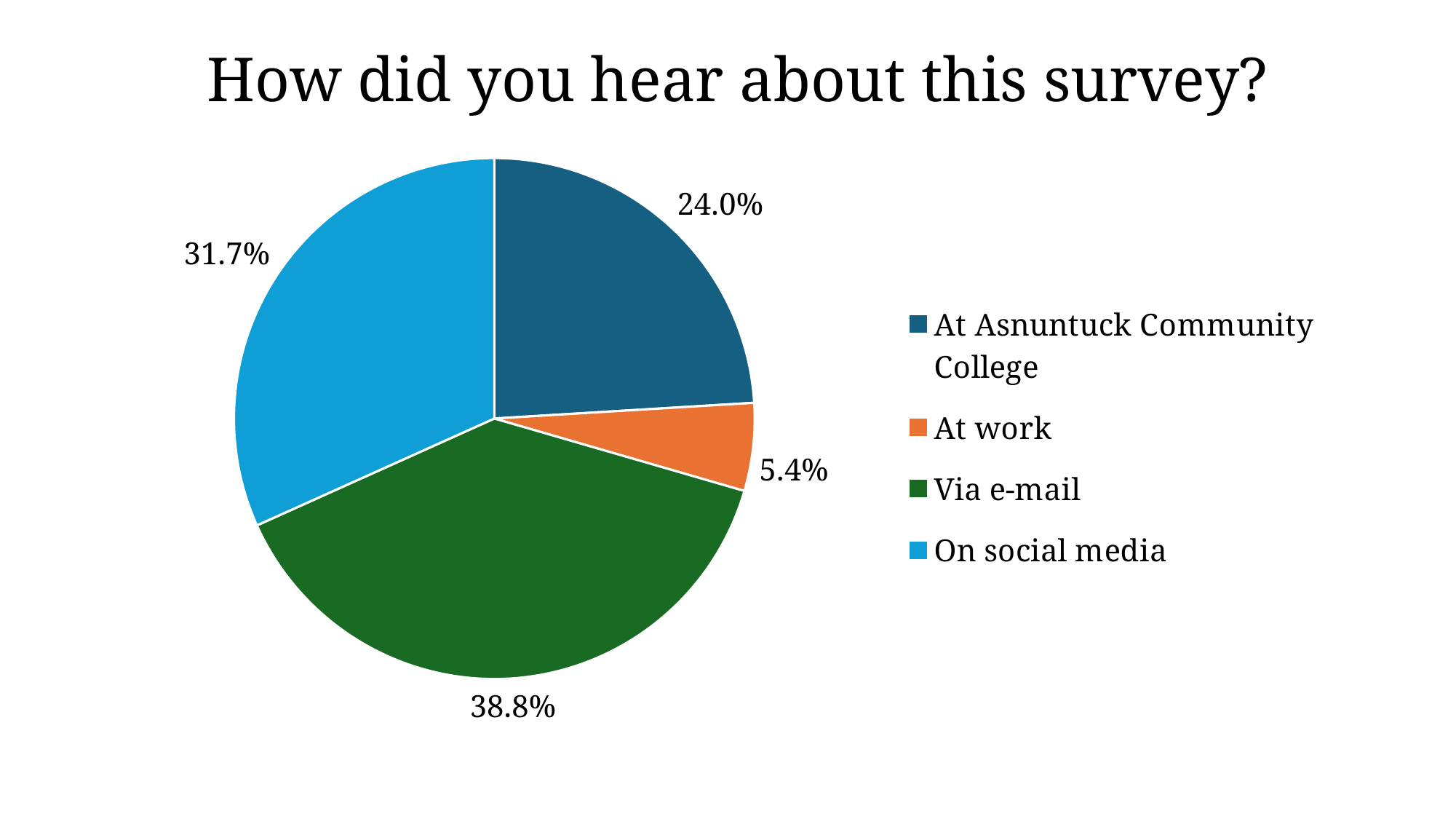
What percentage of respondents heard about the survey at Asnuntuck Community College? 24.0% What percentage of respondents heard about the survey at work? 5.4% How many categories does the pie chart show? 4 What is the title of the chart? How did you hear about this survey? Which is larger: the share for On social media or the share for At Asnuntuck Community College? On social media What kind of chart is shown on the slide? pie chart What is the difference in percentage points between the Via e-mail share and the At work share? 33.4 What percentage of respondents heard about the survey on social media? 31.7% Which colour represents the At work category in the legend? orange Which category has the smallest share of the pie? At work What percentage of respondents heard about the survey via e-mail? 38.8% Which category has the largest share of the pie? Via e-mail